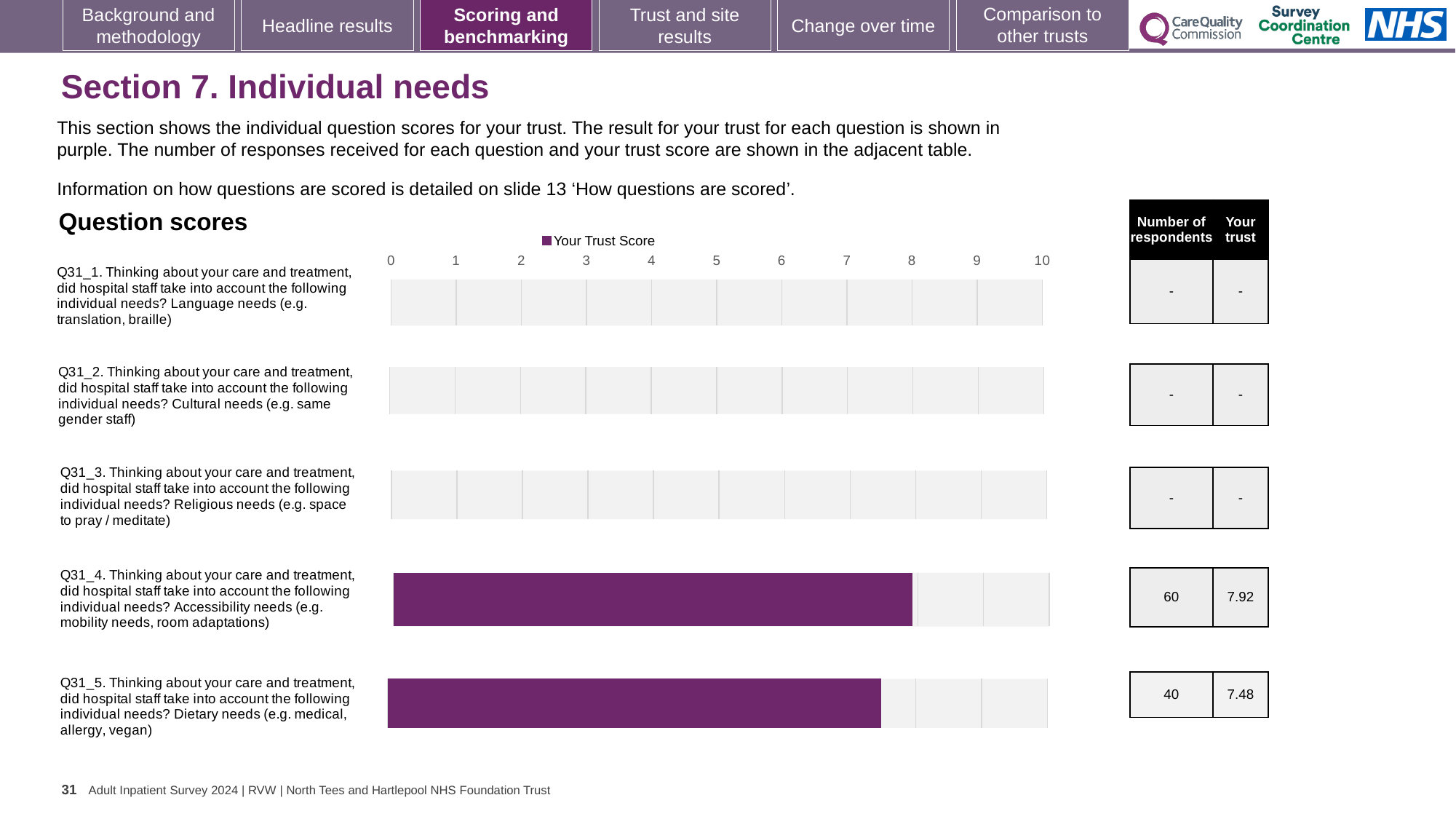
Which question has the higher trust score, Q31_4 or Q31_5? Q31_4 What is the trust score for Q31_5 (Dietary needs)? 7.48 What type of chart is used to show the question scores? Bar chart How many respondents answered Q31_4 (Accessibility needs)? 60 What is the difference between the trust scores for Q31_4 and Q31_5? 0.44 What is the name of the series shown in the chart legend? Your Trust Score What is the trust score for Q31_4 (Accessibility needs)? 7.92 Is the trust score for Q31_4 (Accessibility needs) greater or less than 7? greater How many series does the chart legend list? 1 How many respondents answered Q31_5 (Dietary needs)? 40 Is the trust score for Q31_5 (Dietary needs) greater or less than 8? less How many questions are listed in the Question scores chart? 5